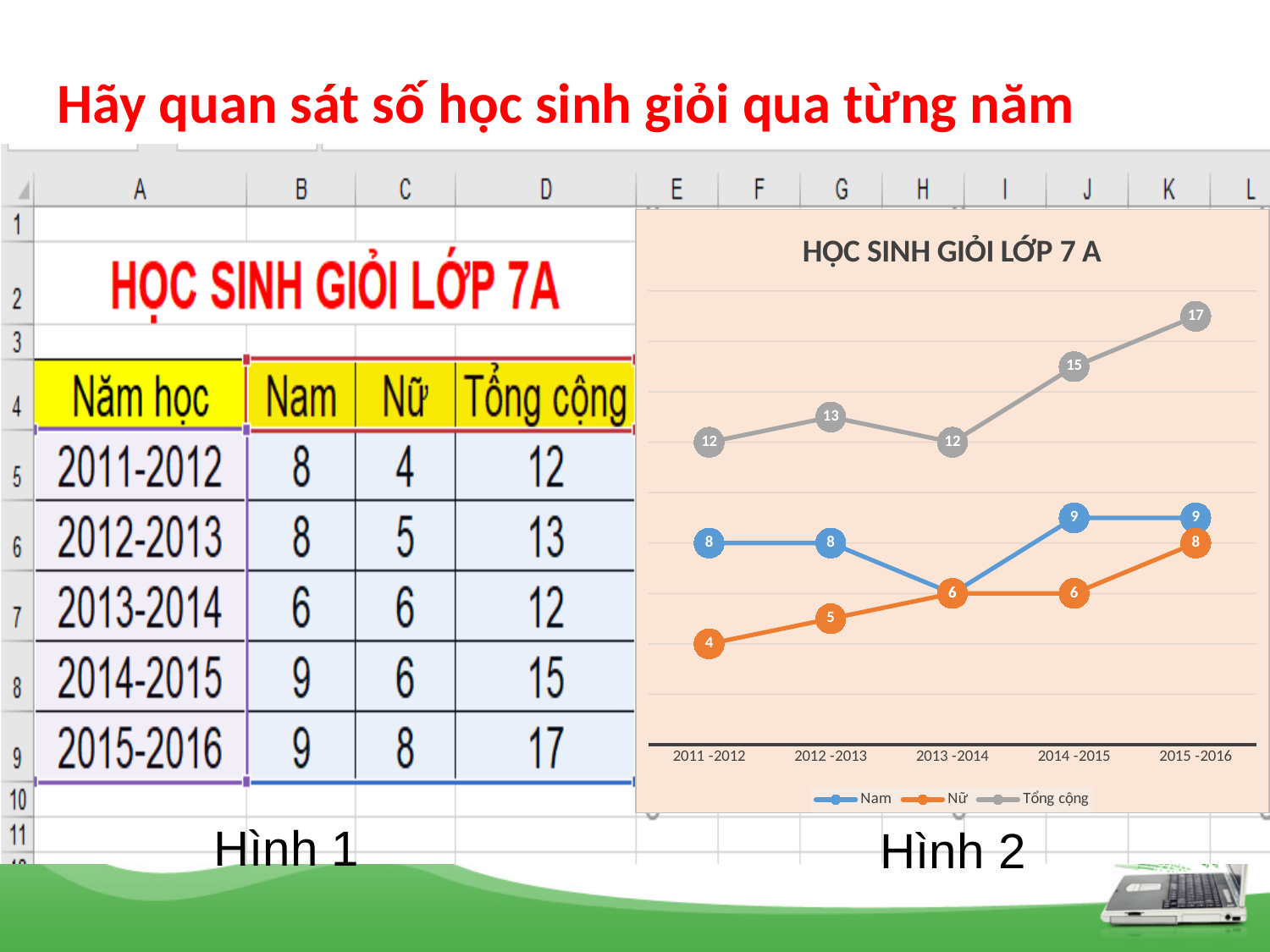
How many school years are plotted along the x axis of the chart? 5 Does the Nữ series rise or fall from 2011-2012 to 2015-2016? rise How many series does the chart's legend list? 3 In which school year is the Tổng cộng series highest? 2015-2016 What is the value of the Nữ series for 2011-2012? 4 What is the value of the Nam series for 2013-2014? 6 What is the title of the chart? HỌC SINH GIỎI LỚP 7 A In which school year is the Nữ series lowest? 2011-2012 What kind of chart is shown on the slide? line chart Which is larger in 2012-2013, the Nam value or the Nữ value? Nam What is the value of the Tổng cộng series for 2014-2015? 15 What is the difference between the Tổng cộng values for 2015-2016 and 2011-2012? 5